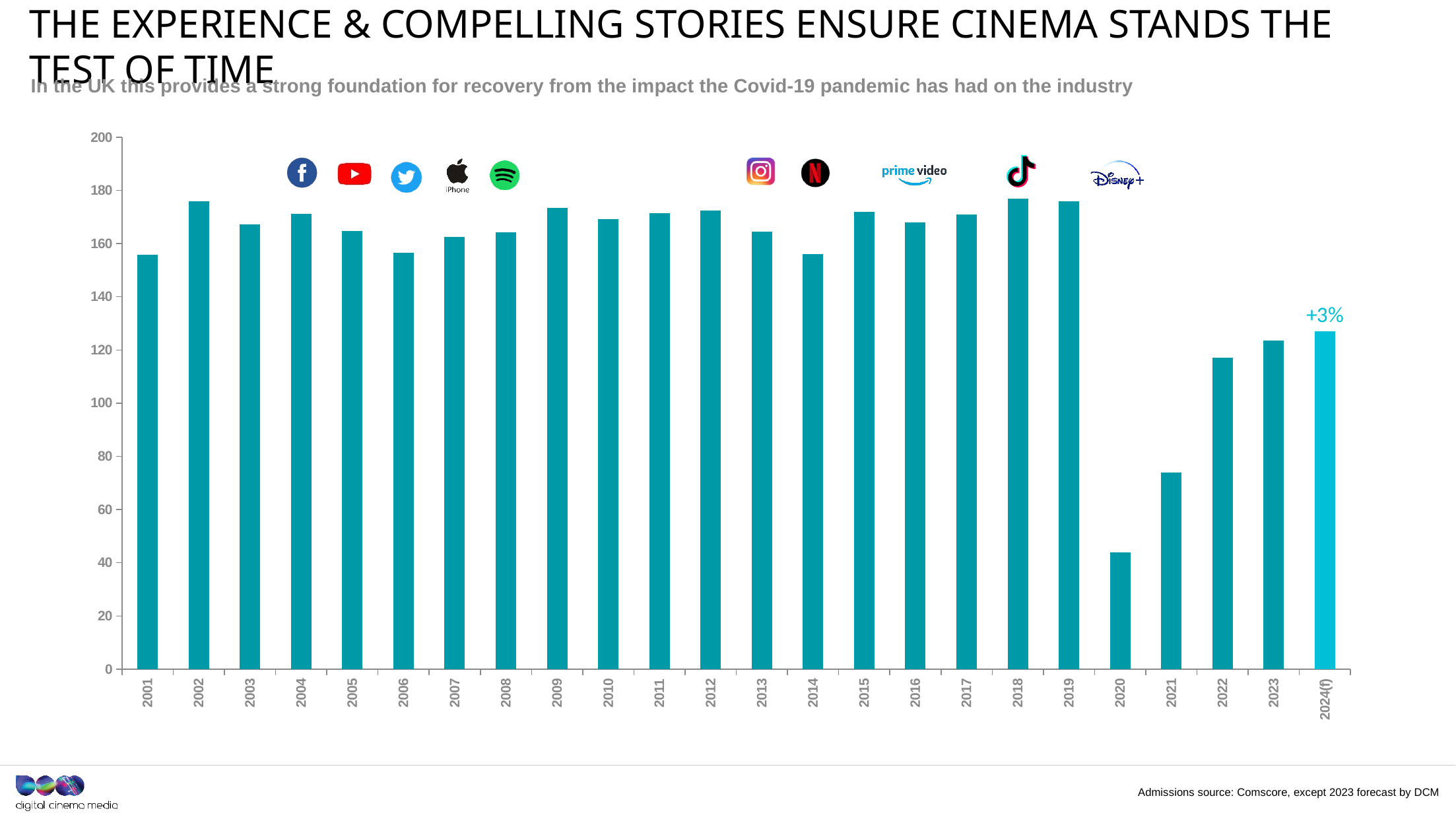
Which year has the lowest bar on the chart? 2020 Is the value for 2001 greater or less than 160? less Is the value for 2022 greater or less than 120? less Is the value for 2023 greater or less than 120? greater Do the values rise or fall from 2020 to 2023? rise What percentage change is annotated above the 2024(f) bar? +3% How many bars (years) are plotted on the chart? 24 What kind of chart is shown on the slide? bar chart What is the label of the last bar on the x axis? 2024(f) Which is larger, the value for 2020 or the value for 2021? 2021